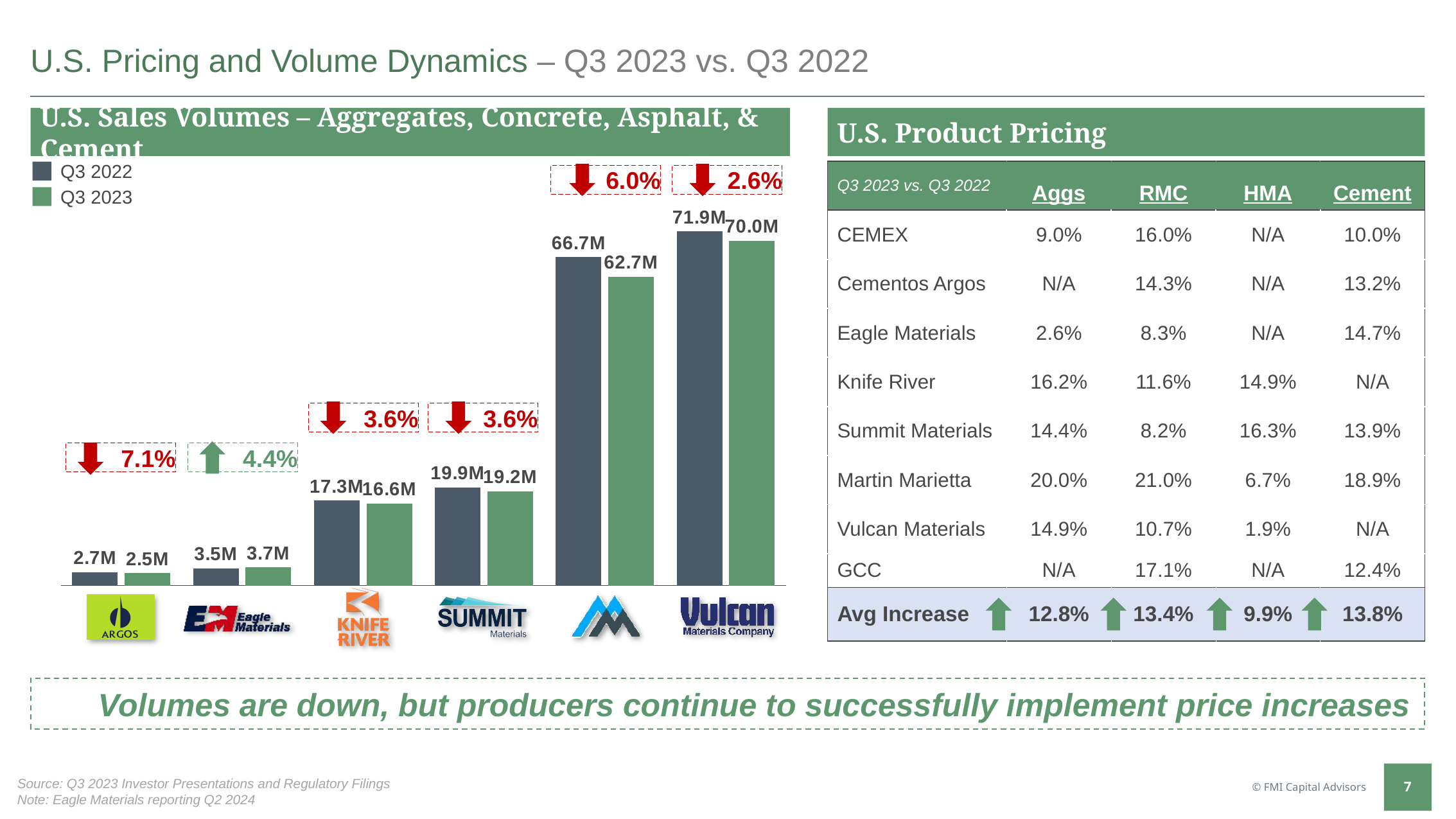
Which company has the lowest Q3 2023 sales volume in the sales volumes chart? Argos What is the Q3 2022 sales volume for Knife River in the sales volumes chart? 17.3M What is the Q3 2023 sales volume for Summit Materials in the sales volumes chart? 19.2M What type of chart is shown under the title 'U.S. Sales Volumes – Aggregates, Concrete, Asphalt, & Cement'? Bar chart What percentage change is shown above the Argos bars in the sales volumes chart? 7.1% decrease What is the Q3 2023 sales volume for Vulcan Materials in the sales volumes chart? 70.0M In the sales volumes chart, what is the difference between Vulcan Materials' Q3 2022 and Q3 2023 volumes? 1.9M What are the two series named in the legend of the sales volumes chart? Q3 2022 and Q3 2023 In the sales volumes chart, is Eagle Materials' Q3 2023 volume larger or smaller than its Q3 2022 volume? Larger How many companies are shown on the x axis of the sales volumes chart? 6 Which company has the highest Q3 2022 sales volume in the sales volumes chart? Vulcan Materials How many series does the legend of the sales volumes chart list? 2